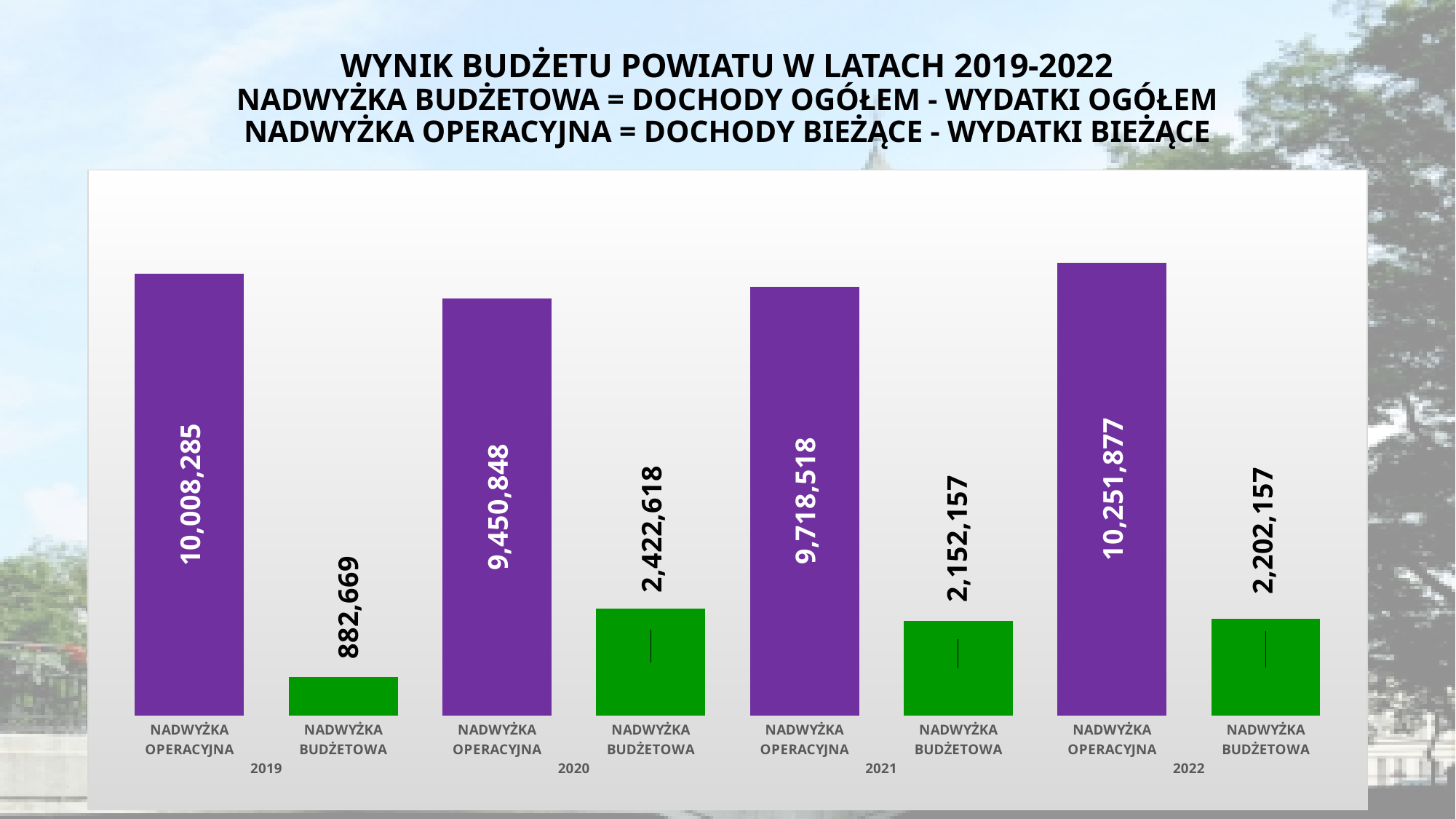
Which is larger: NADWYŻKA OPERACYJNA in 2020 or NADWYŻKA OPERACYJNA in 2021? NADWYŻKA OPERACYJNA in 2021 What is the value of NADWYŻKA BUDŻETOWA for 2022? 2,202,157 By how much does NADWYŻKA BUDŻETOWA in 2022 exceed NADWYŻKA BUDŻETOWA in 2021? 50,000 What is the value of NADWYŻKA BUDŻETOWA for 2020? 2,422,618 What is the value of NADWYŻKA OPERACYJNA for 2019? 10,008,285 What is the value of NADWYŻKA OPERACYJNA for 2021? 9,718,518 In which year is NADWYŻKA BUDŻETOWA the lowest? 2019 How many bars are plotted on the chart? 8 What colour are the NADWYŻKA BUDŻETOWA bars? Green In which year is NADWYŻKA OPERACYJNA the highest? 2022 What is the difference between NADWYŻKA OPERACYJNA and NADWYŻKA BUDŻETOWA in 2019? 9,125,616 What kind of chart is shown on the slide? Bar chart